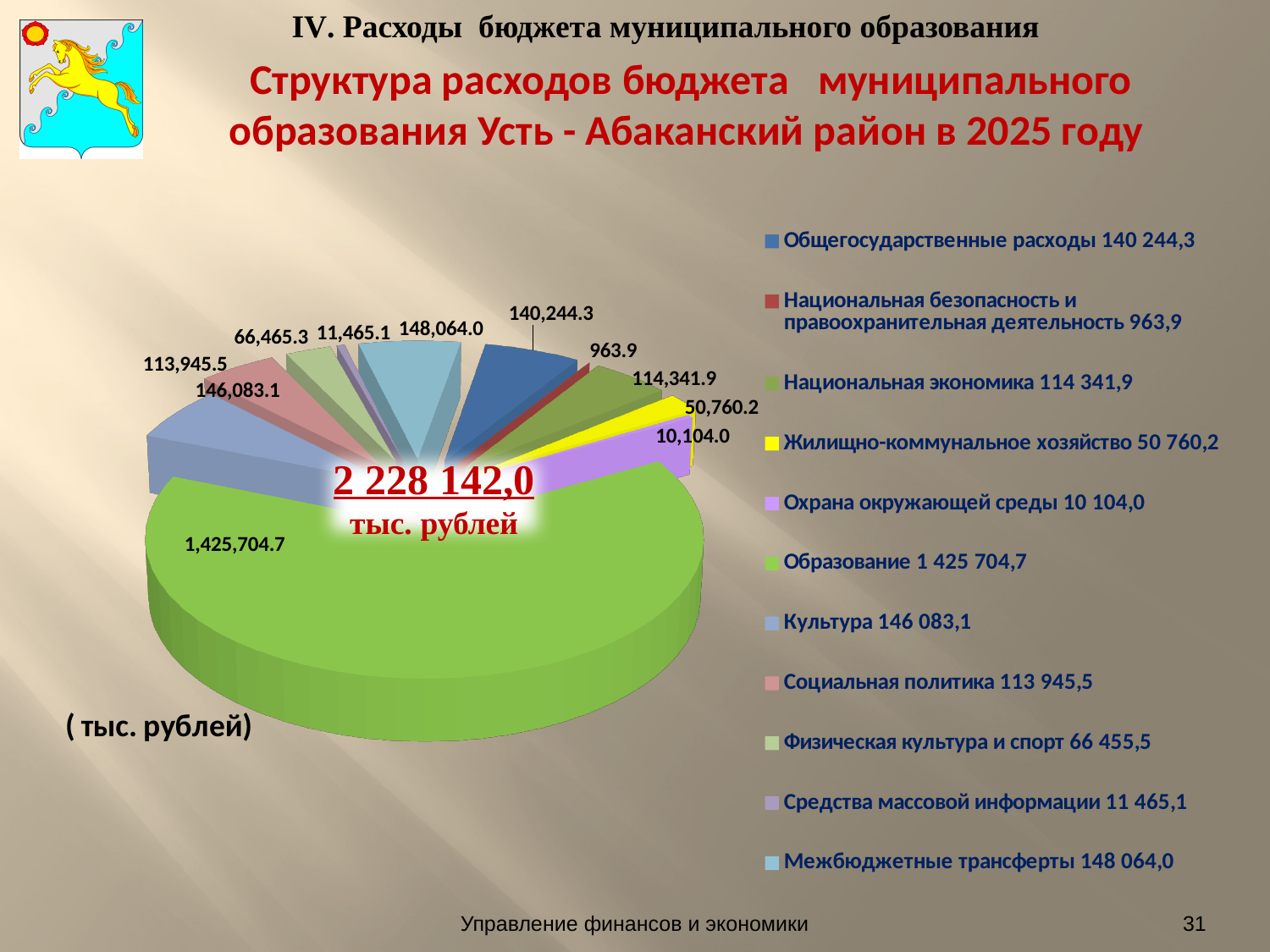
How many categories (slices) does the pie chart have? 11 What is the difference between the values for Межбюджетные трансферты and Культура? 1,980.9 Which category has the smallest value in the pie chart? Национальная безопасность и правоохранительная деятельность In what units are the values of the pie chart given? тыс. рублей Which is larger: the value for Культура or the value for Социальная политика? Культура What is the value for Межбюджетные трансферты in the pie chart? 148,064.0 What is the value for Жилищно-коммунальное хозяйство in the pie chart? 50,760.2 What is the value for Образование in the pie chart? 1,425,704.7 Which category has the largest value in the pie chart? Образование What is the value for Средства массовой информации in the pie chart? 11,465.1 What total amount is printed in the centre of the pie chart? 2 228 142,0 тыс. рублей What kind of chart is shown on the slide? Pie chart